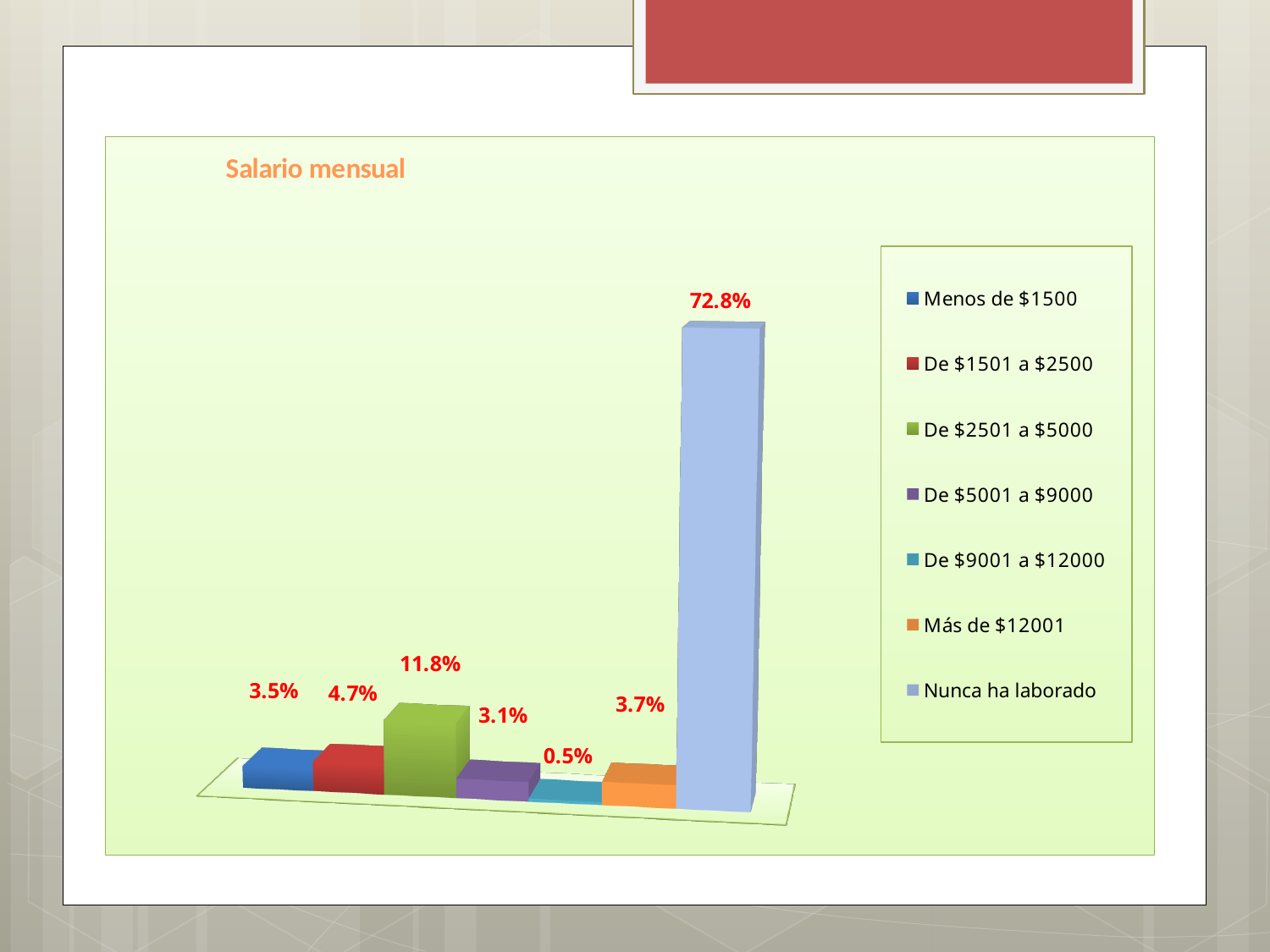
Which category has the lowest value? De $9001 a $12000 What is the title of the chart? Salario mensual Which is larger, the value for "De $1501 a $2500" or the value for "Más de $12001"? De $1501 a $2500 What is the value for "Nunca ha laborado"? 72.8% What is the difference between the values for "Nunca ha laborado" and "De $2501 a $5000"? 61.0% How many categories are shown in the chart? 7 What colour is the bar for "De $2501 a $5000"? Green What kind of chart is shown? Bar chart What is the value for "Menos de $1500"? 3.5% What is the value for "De $2501 a $5000"? 11.8% Which category has the highest value? Nunca ha laborado What is the value for "De $9001 a $12000"? 0.5%